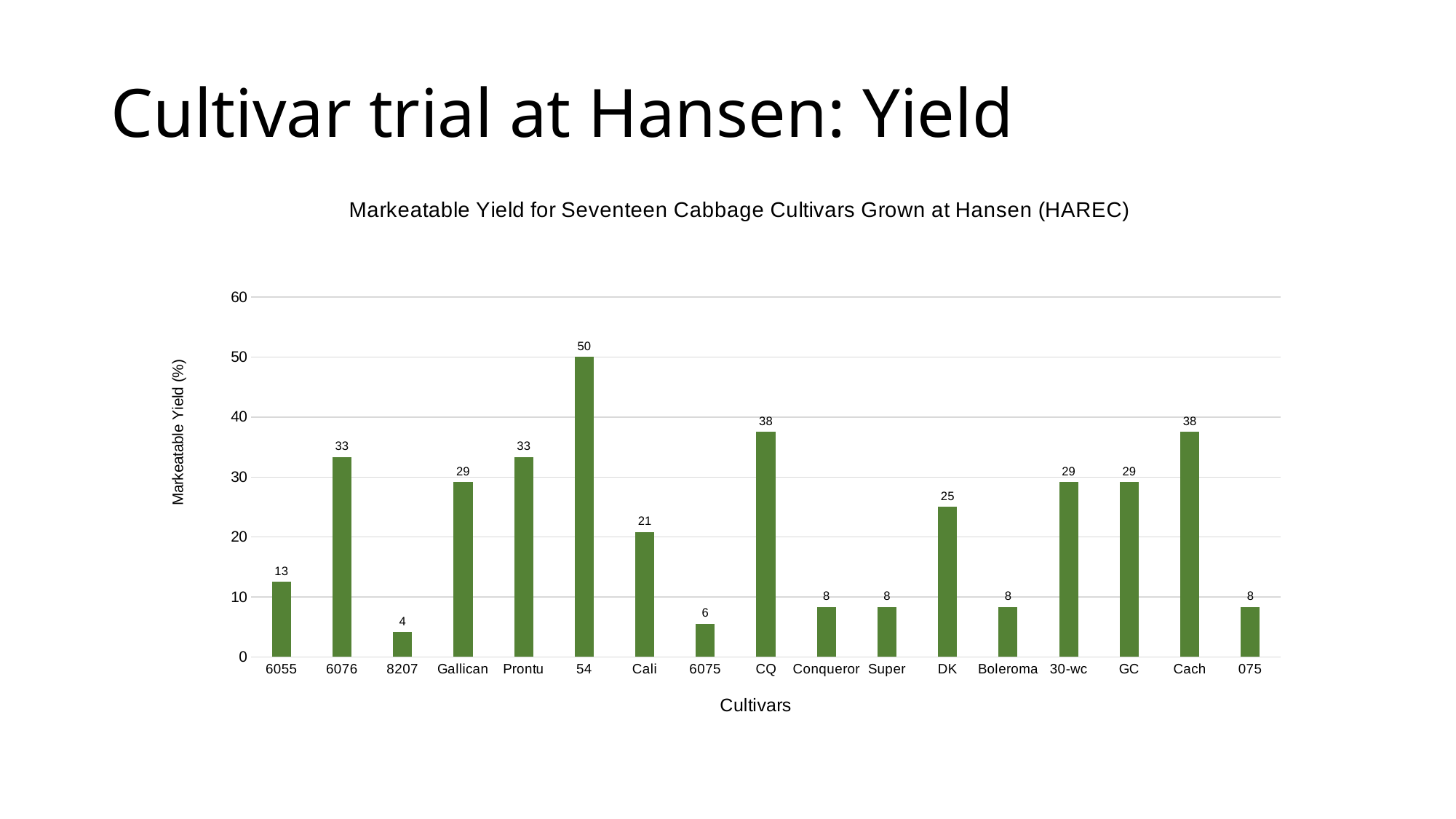
What is the title of the chart? Markeatable Yield for Seventeen Cabbage Cultivars Grown at Hansen (HAREC) Which cultivar has the lowest marketable yield? 8207 What kind of chart is shown on the slide? bar chart What is the label of the y axis? Markeatable Yield (%) What is the marketable yield for cultivar 54? 50 Which has a higher marketable yield, 6076 or Cali? 6076 What is the marketable yield for cultivar DK? 25 What is the difference in marketable yield between cultivar 54 and cultivar CQ? 12 Which cultivar has the highest marketable yield? 54 Is the marketable yield for cultivar 6055 greater or less than 20? less What is the marketable yield for cultivar Gallican? 29 How many cultivars are shown on the chart? 17